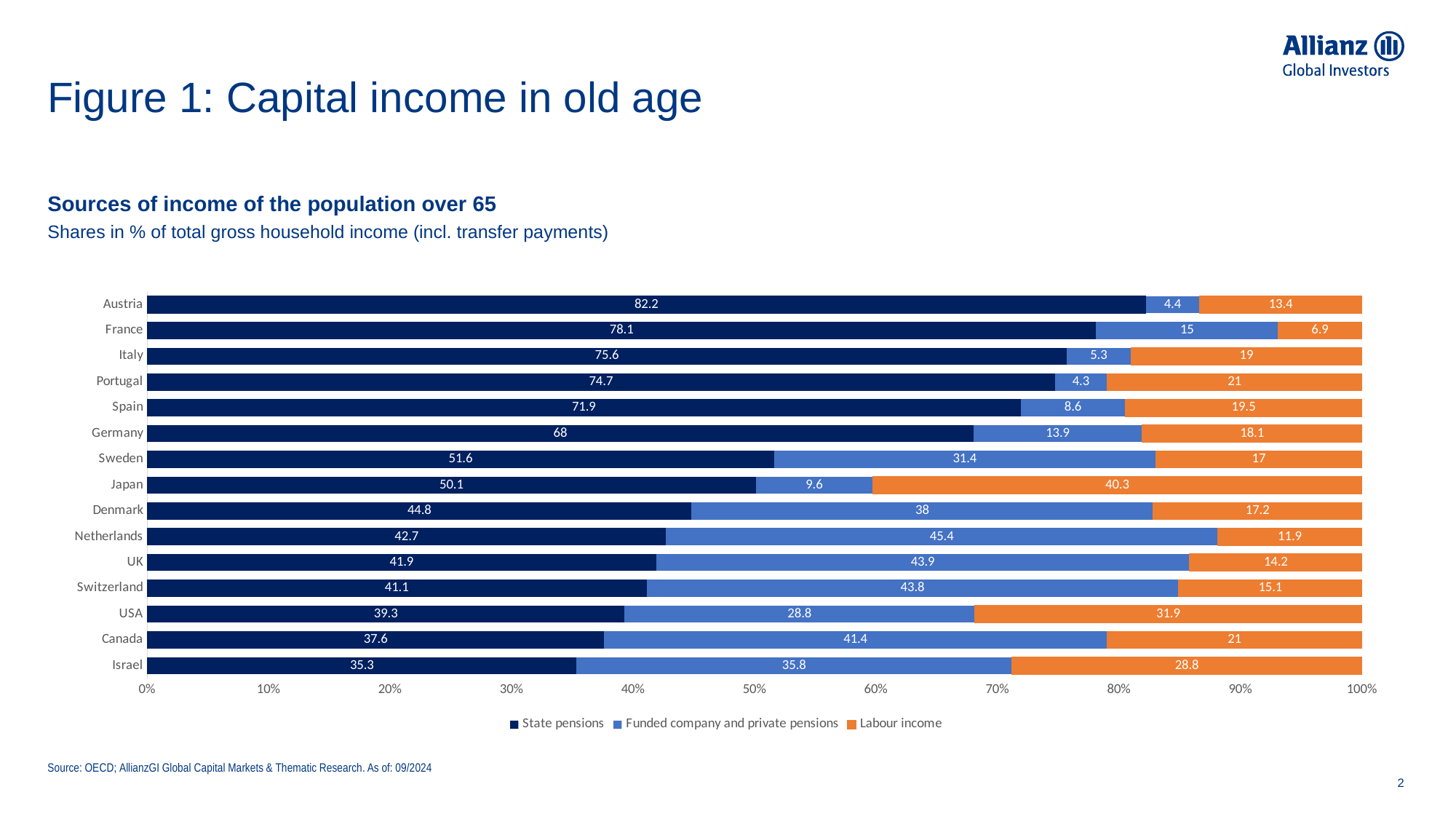
What is the State pensions value for Austria? 82.2 Which country has the lowest State pensions share? Israel Which country has the highest State pensions share? Austria How many countries are shown in the chart? 15 Which is larger, the Funded company and private pensions value for Sweden or for Denmark? Denmark What kind of chart is shown on the slide? Stacked bar chart Which country has the highest Labour income share? Japan What is the Labour income value for Japan? 40.3 What is the difference between the State pensions values for Austria and Israel? 46.9 What is the Funded company and private pensions value for the Netherlands? 45.4 How many series does the legend list? 3 What is the total of the three values for Germany? 100